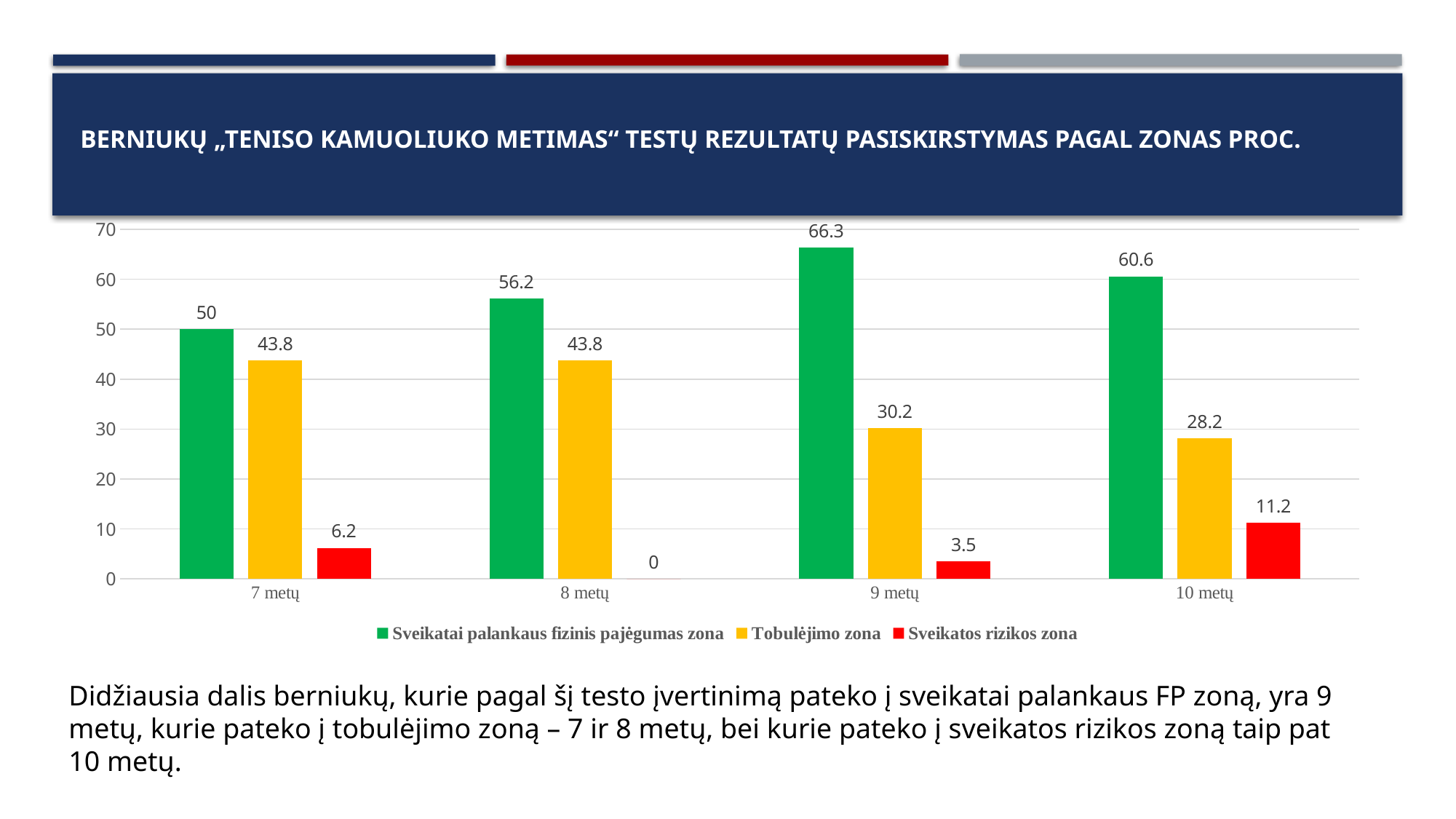
How many age groups are shown on the x axis? 4 Which is larger: 'Sveikatos rizikos zona' at 10 metų or at 7 metų? 10 metų What kind of chart is shown on the slide? Bar chart Does the 'Tobulėjimo zona' value rise or fall from 8 metų to 10 metų? Fall What is the value for 'Sveikatos rizikos zona' at 8 metų? 0 Which age group has the lowest value for 'Sveikatos rizikos zona'? 8 metų What is the difference between the 'Sveikatai palankaus fizinis pajėgumas zona' values for 9 metų and 7 metų? 16.3 What is the value for 'Tobulėjimo zona' at 10 metų? 28.2 How many series does the legend list? 3 Which age group has the highest value for 'Sveikatai palankaus fizinis pajėgumas zona'? 9 metų What is the value for 'Sveikatai palankaus fizinis pajėgumas zona' at 9 metų? 66.3 What colour are the bars for 'Sveikatos rizikos zona'? Red